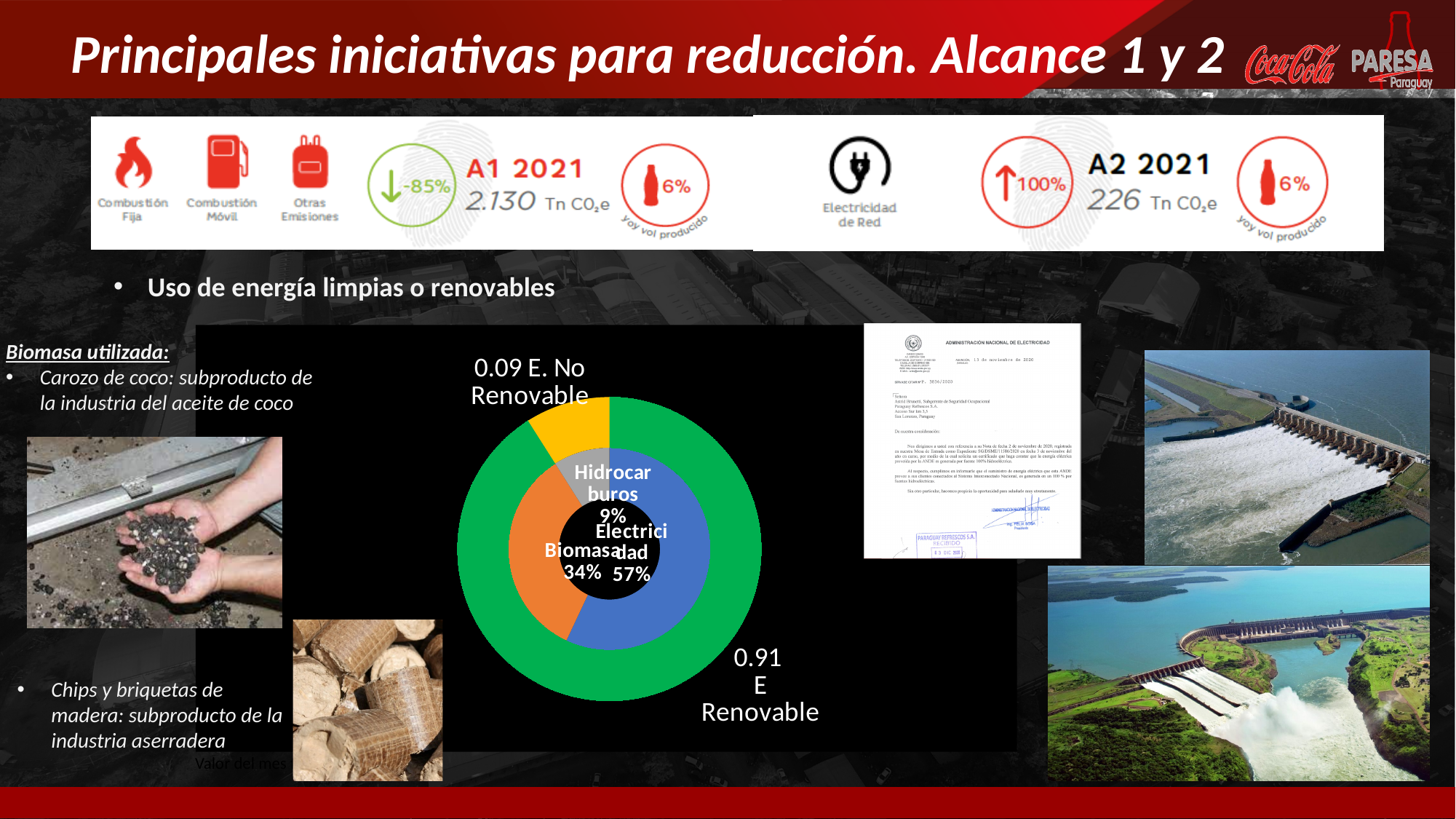
In the outer ring of the doughnut chart, what value is shown for E. Renovable? 0.91 How many categories are shown in the outer ring of the doughnut chart? 2 How many categories are shown in the inner ring of the doughnut chart? 3 In the outer ring of the doughnut chart, which is larger: E. Renovable or E. No Renovable? E. Renovable Which category has the largest share in the inner ring of the doughnut chart? Electricidad In the outer ring of the doughnut chart, what value is shown for E. No Renovable? 0.09 Which category has the smallest share in the inner ring of the doughnut chart? Hidrocarburos In the inner ring of the doughnut chart, what share does Electricidad have? 57% In the inner ring of the doughnut chart, what share does Hidrocarburos have? 9% In the inner ring of the doughnut chart, what is the difference between the Electricidad share and the Biomasa share? 23% In the inner ring of the doughnut chart, what share does Biomasa have? 34% What kind of chart is shown in the centre of the slide? doughnut chart